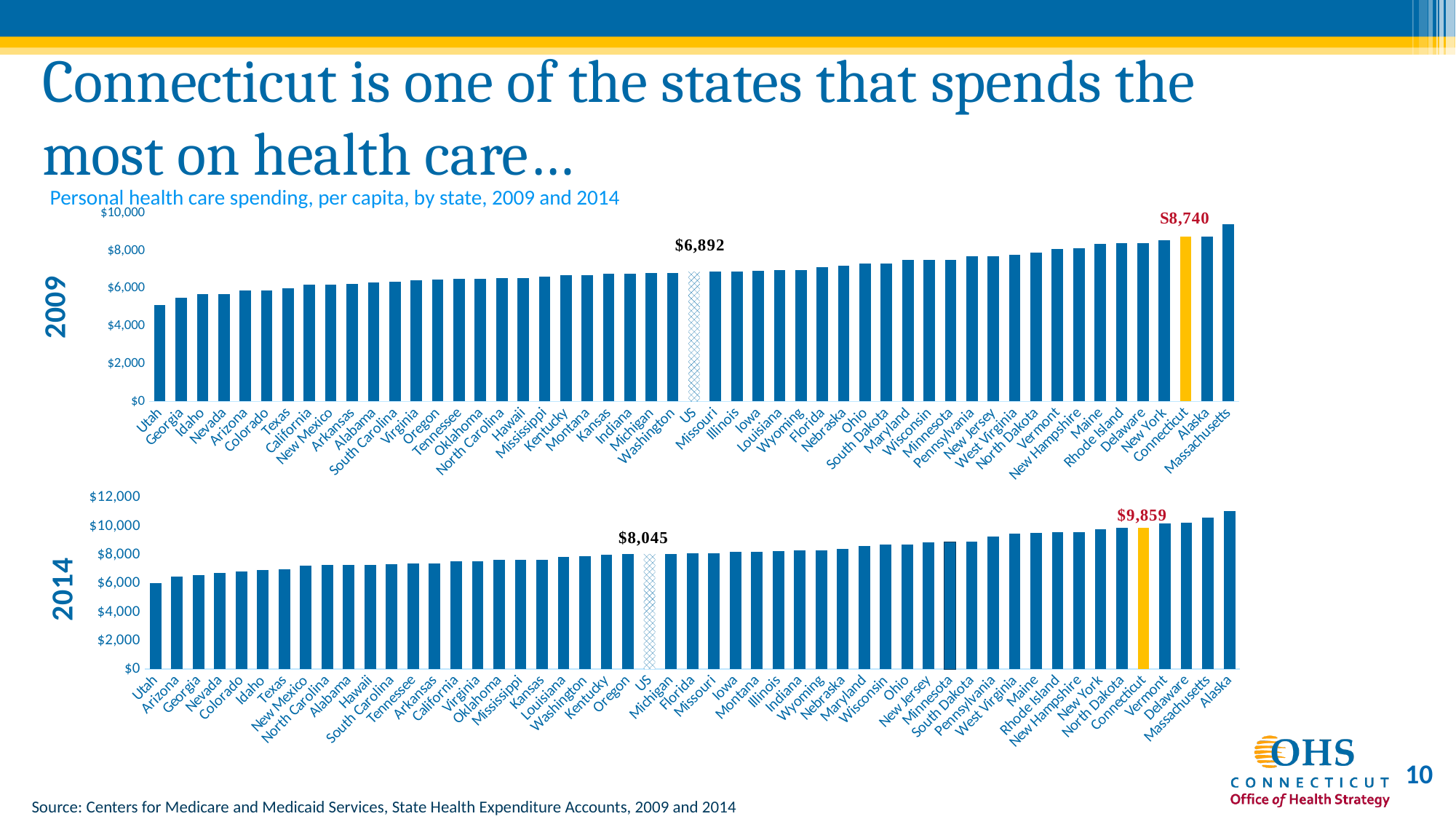
In the 2014 chart, what is the per capita personal health care spending for Connecticut? $9,859 In the 2014 chart, how much higher is Connecticut's per capita spending than the US figure? $1,814 In the 2009 chart, is the value for Utah greater or less than $6,000? less In the 2009 chart, which state has the lowest per capita spending? Utah In the 2009 chart, what is the per capita personal health care spending for the US? $6,892 In the 2014 chart, what is the per capita personal health care spending for the US? $8,045 What type of chart is used for the 2014 data? Bar chart In the 2014 chart, is the value for Alaska greater or less than $10,000? greater In the 2009 chart, what is the per capita personal health care spending for Connecticut? $8,740 In the 2009 chart, how much higher is Connecticut's per capita spending than the US figure? $1,848 In the 2014 chart, which state has the highest per capita spending? Alaska In the 2009 chart, which state has the highest per capita spending? Massachusetts